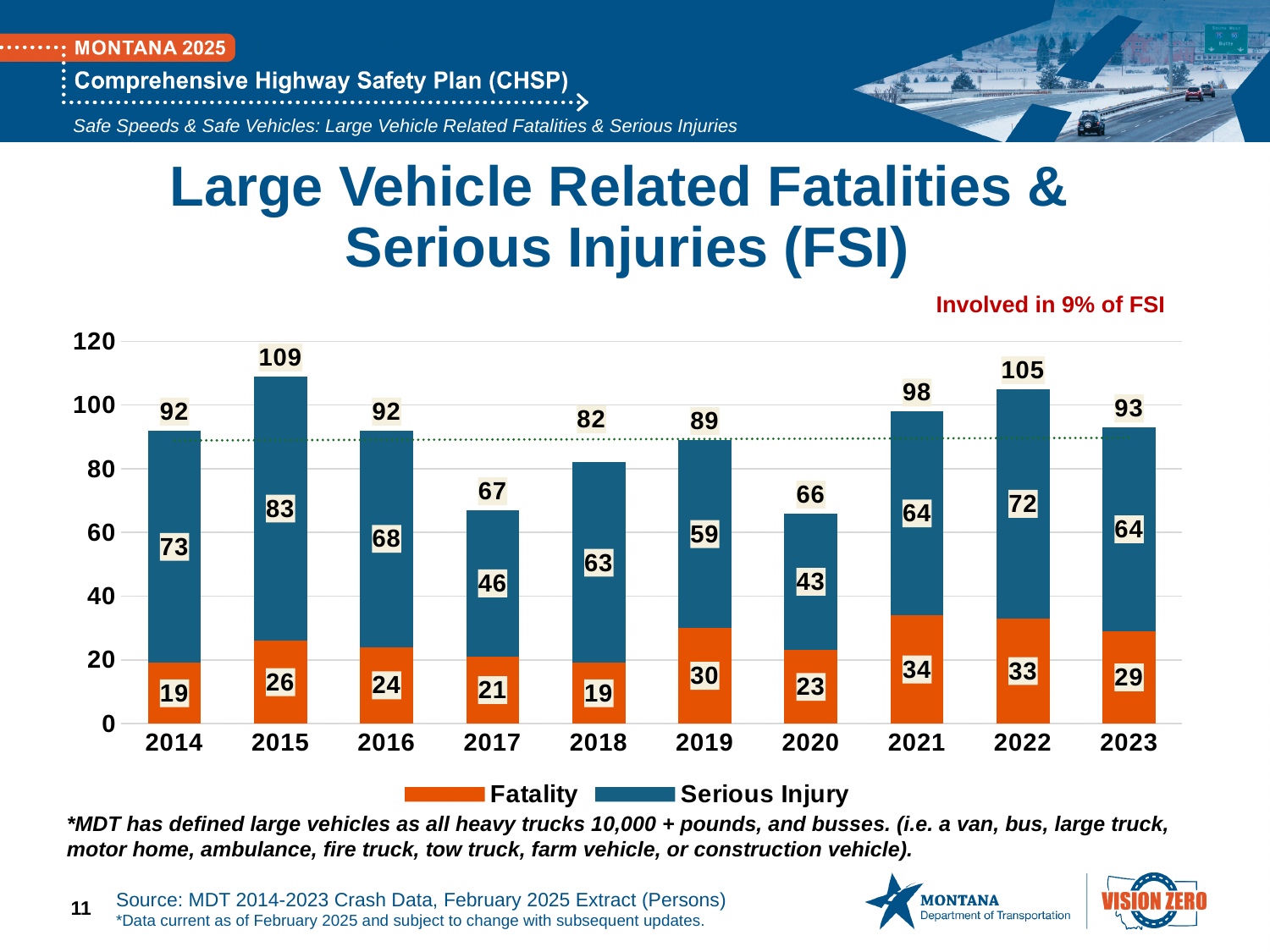
Which year has the lowest Serious Injury value? 2020 Which is larger, the Serious Injury value for 2016 or for 2017? 2016 Does the total FSI rise or fall from 2020 to 2022? Rise What is the Serious Injury value for 2015? 83 How many years are shown on the x axis? 10 What kind of chart is shown on the slide? Stacked bar chart What is the difference between the Fatality values for 2019 and 2018? 11 Which colour represents Fatality in the legend? Orange What is the total of the stacked bar for 2022? 105 Which year has the highest total large vehicle related FSI? 2015 How many series does the legend list? 2 What is the Fatality value for 2021? 34